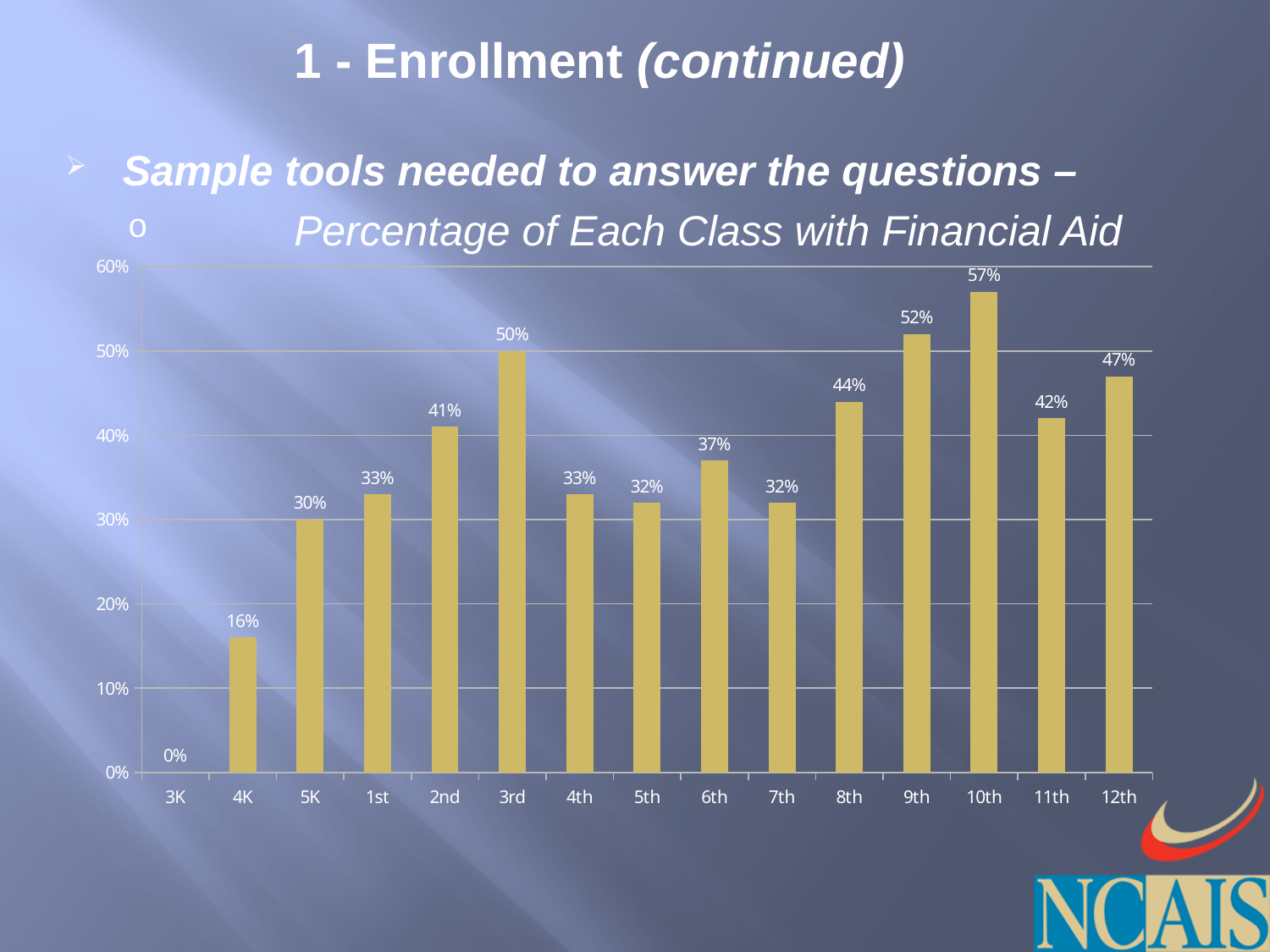
What percentage of the 3rd grade class has financial aid? 50% Which class has the highest percentage with financial aid? 10th What is the value shown for 4K? 16% Which has a higher percentage with financial aid, 6th or 8th? 8th What is the difference between the percentages for 10th and 12th? 10% Which class has the lowest percentage with financial aid? 3K Is the value for 9th greater or less than 50%? greater Do the values rise or fall from 7th to 10th? Rise What percentage of the 11th grade class has financial aid? 42% What kind of chart is shown on the slide? Bar chart What is the title of the chart? Percentage of Each Class with Financial Aid How many classes are shown on the x axis? 15